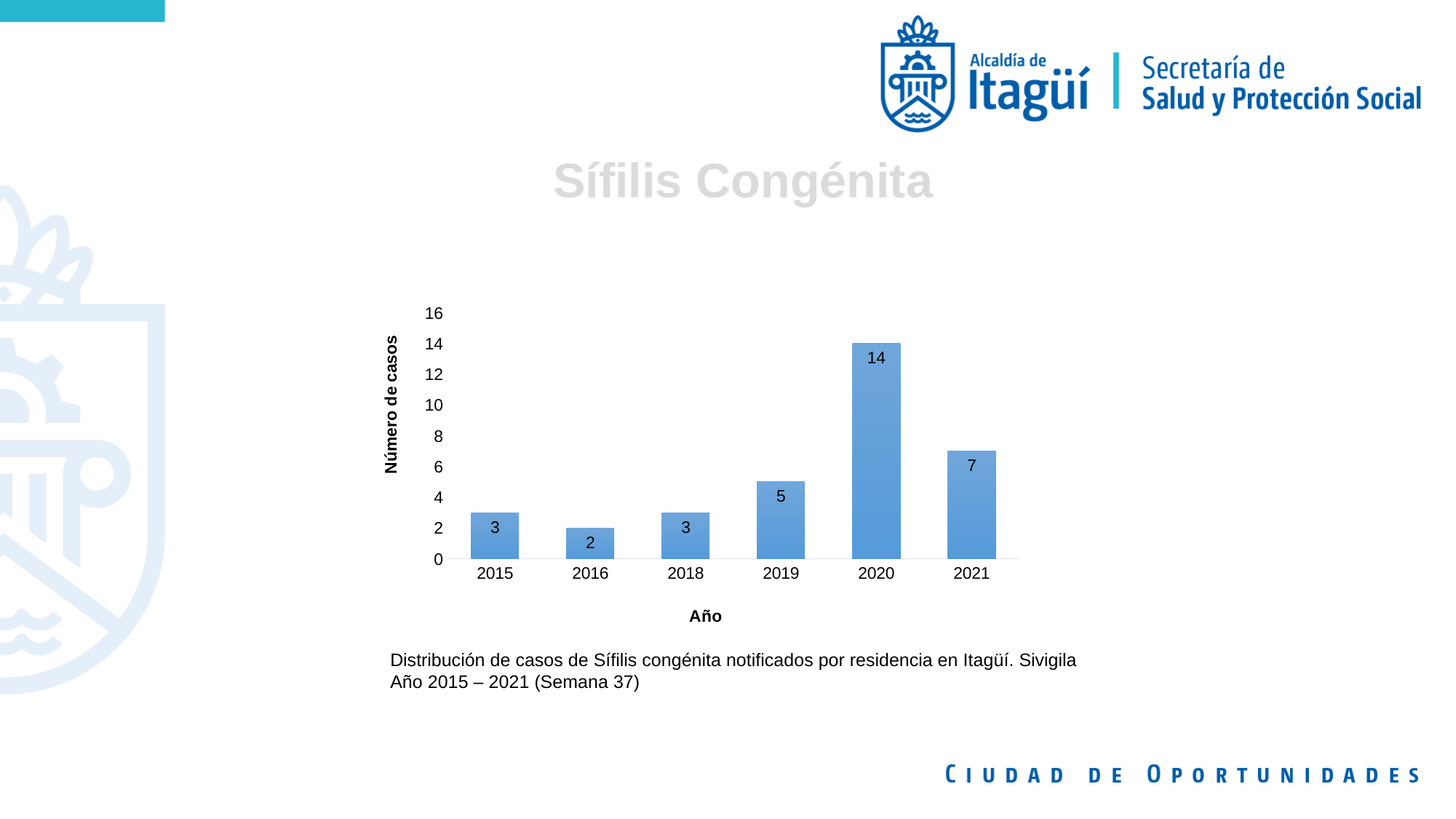
How many cases are shown for 2020? 14 Do the values rise or fall from 2018 to 2020? Rise What is the difference in cases between 2020 and 2021? 7 What is the label of the y axis? Número de casos What is the number of cases for 2016? 2 Which year has the lowest number of cases? 2016 What kind of chart is shown on the slide? Bar chart What is the value for 2021? 7 Which year has more cases, 2019 or 2021? 2021 How many years are shown on the x axis? 6 Which year has the highest number of cases? 2020 Is the value for 2020 greater or less than 12? greater